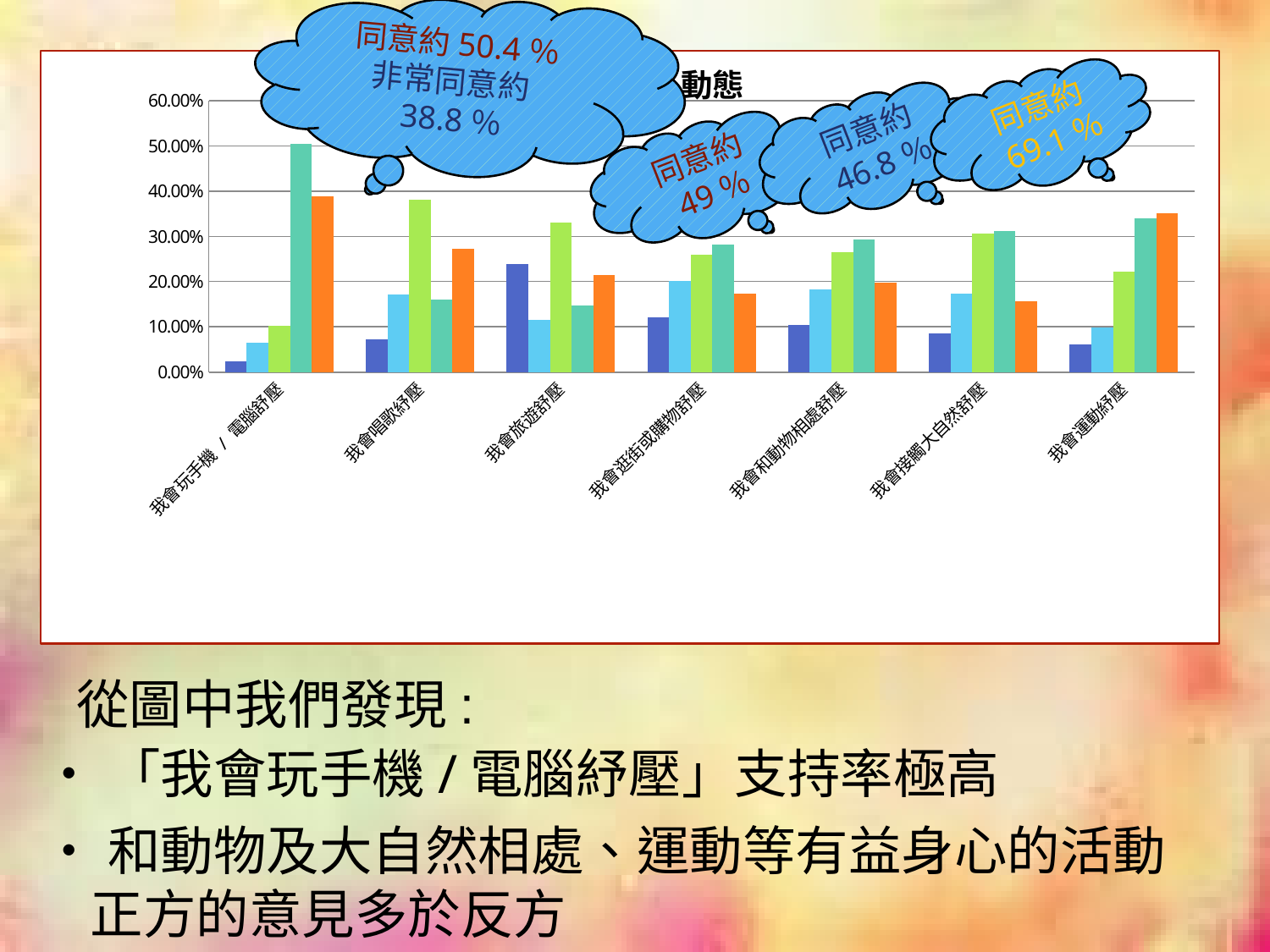
Is the dark blue bar for 我會旅遊紓壓 greater or less than 20.00%? greater What is the highest value shown on the chart's y axis? 60.00% What kind of chart is shown on the slide? bar chart Is the dark blue bar for 我會玩手機／電腦紓壓 greater or less than 10.00%? less How many categories are shown along the x axis of the chart? 7 Which category has the tallest bar in the chart? 我會玩手機／電腦紓壓 Which has the larger teal bar: 我會玩手機／電腦紓壓 or 我會運動紓壓? 我會玩手機／電腦紓壓 Is the tallest bar for 我會玩手機／電腦紓壓 greater or less than 40.00%? greater According to the callout above the chart, what percentage agreed (同意) for the first category? 50.4 % Which has the larger dark blue bar: 我會旅遊紓壓 or 我會玩手機／電腦紓壓? 我會旅遊紓壓